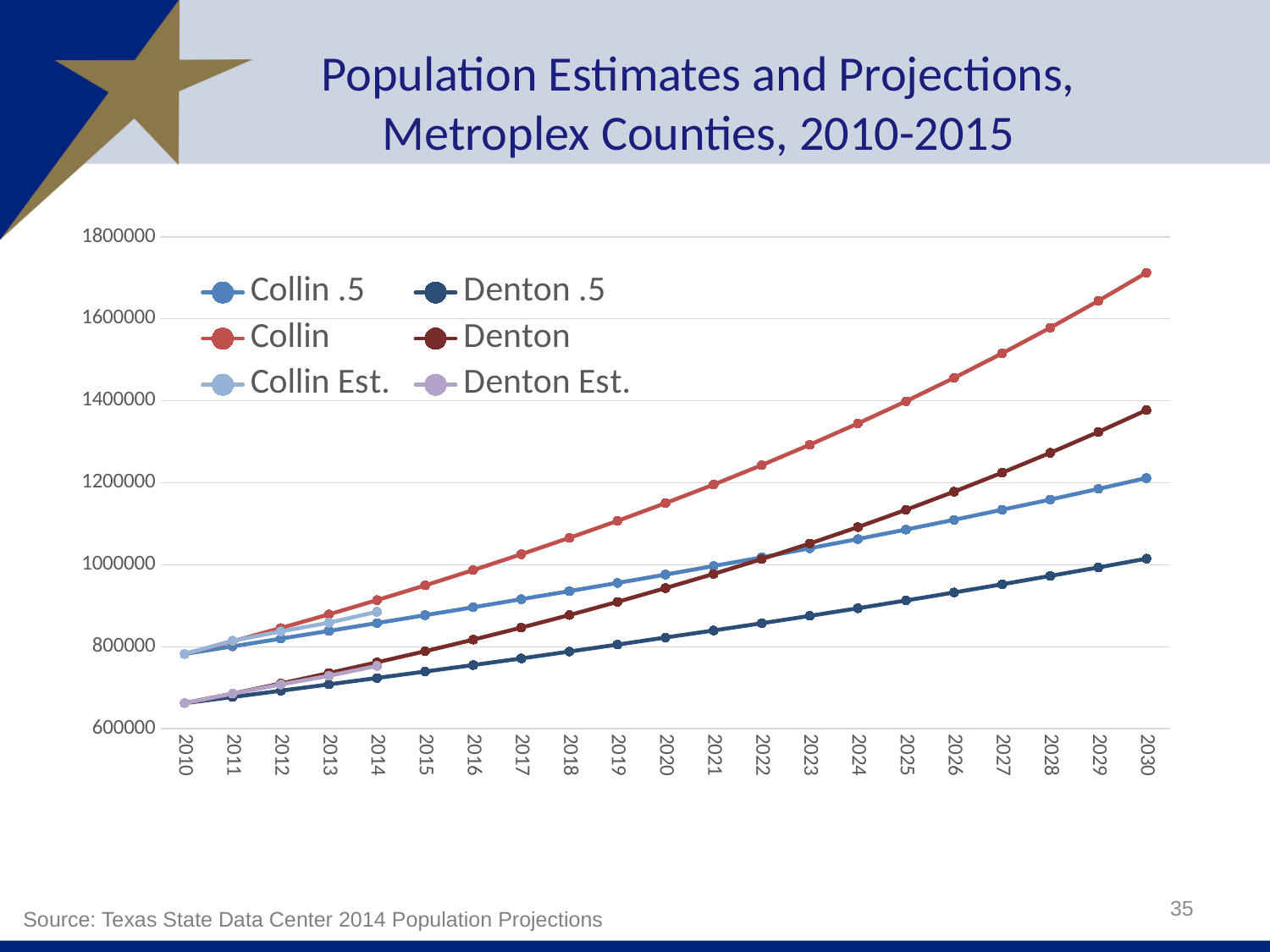
Is the value for Denton .5 in 2030 greater or less than 800000? greater Is the value for Denton in 2010 greater or less than 600000? greater Is the value for Collin in 2030 greater or less than 1600000? greater In 2030, which is larger: Collin .5 or Denton? Denton Which series has the lowest value in 2030? Denton .5 What is the title of the chart on the slide? Population Estimates and Projections, Metroplex Counties, 2010-2015 Does the Collin series rise or fall from 2010 to 2030? Rises How many series does the legend list? 6 What kind of chart is shown on the slide? Line chart Which series has the highest value in 2030? Collin How many years are shown along the x axis? 21